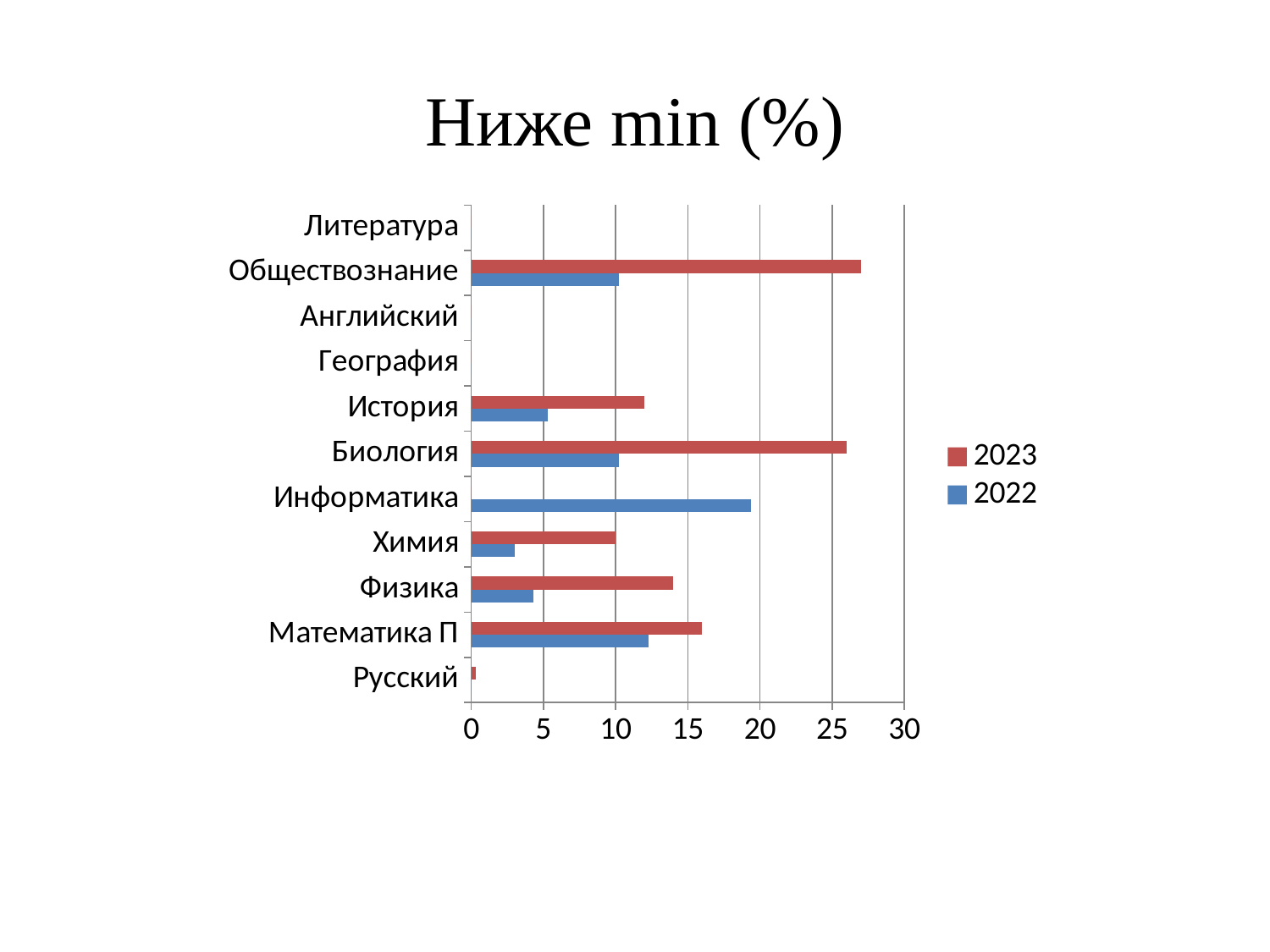
Which category has the highest value for the 2022 series? Информатика How many categories are shown on the vertical axis of the chart? 11 For Информатика, which series has the larger value, 2023 or 2022? 2022 For Обществознание, which series has the larger value, 2023 or 2022? 2023 How many series does the legend list? 2 Is the 2023 value for Физика greater or less than 10? greater Is the 2022 value for Информатика greater or less than 15? greater What is the title of the chart? Ниже min (%) What kind of chart is shown on the slide? bar chart Is the 2023 value for Обществознание greater or less than 25? greater Which colour represents the 2023 series in the chart? red